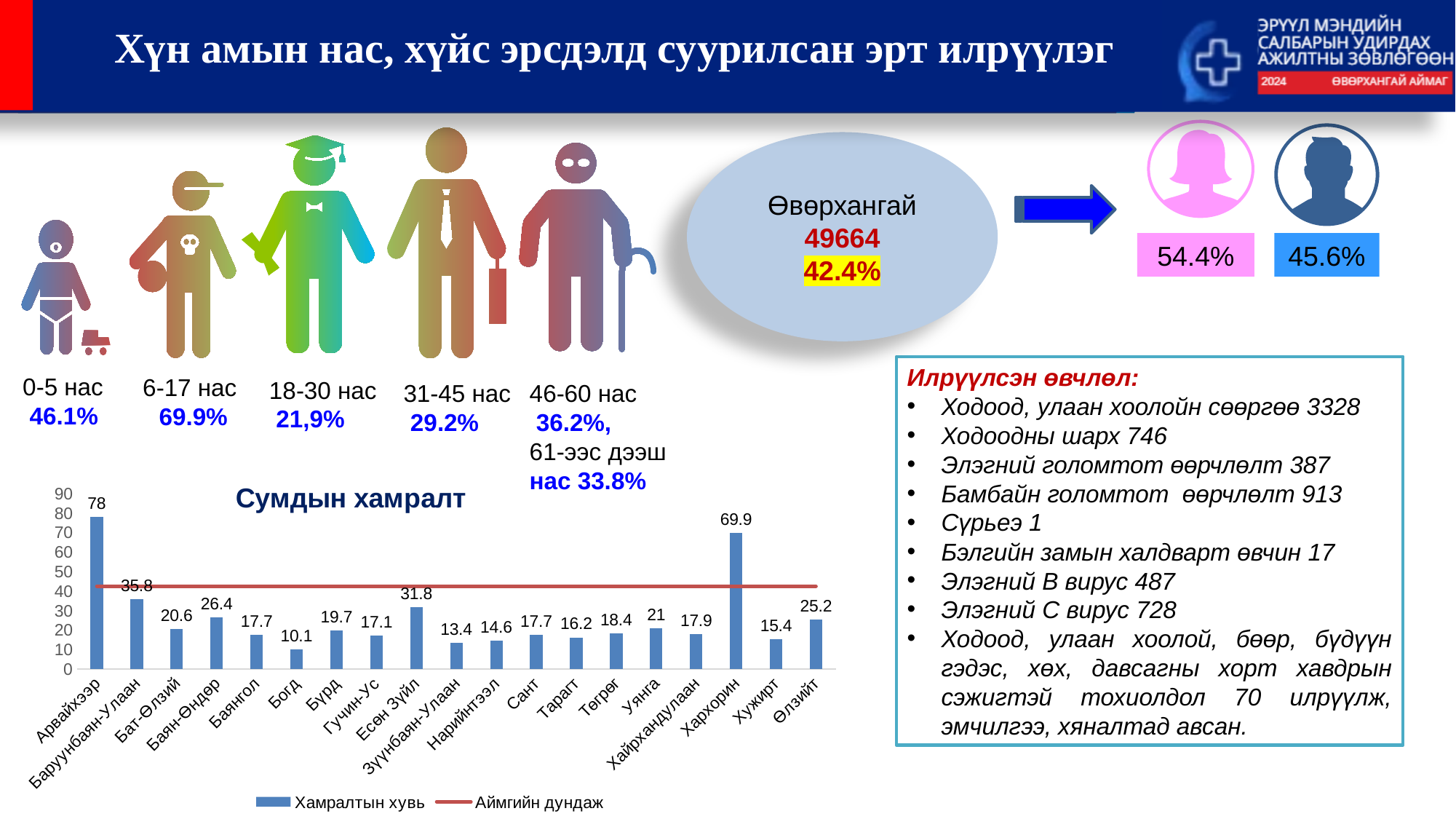
What is the difference between the values for Арвайхээр and Хархорин in the Сумдын хамралт chart? 8.1 Which category has the lowest value in the Сумдын хамралт chart? Богд Which category has the highest value in the Сумдын хамралт chart? Арвайхээр What is the value for Хархорин in the Сумдын хамралт chart? 69.9 In the Сумдын хамралт chart, which is larger: the value for Есөн Зүйл or the value for Баян-Өндөр? Есөн Зүйл What is the value for Богд in the Сумдын хамралт chart? 10.1 What is the name of the line series in the legend of the Сумдын хамралт chart? Аймгийн дундаж What is the value for Арвайхээр in the Сумдын хамралт chart? 78 In the Сумдын хамралт chart, is the value for Баруунбаян-Улаан greater or less than 30? greater How many series does the legend of the Сумдын хамралт chart list? 2 What kind of chart is the Сумдын хамралт chart? Combination bar and line chart How many categories are shown on the x axis of the Сумдын хамралт chart? 19